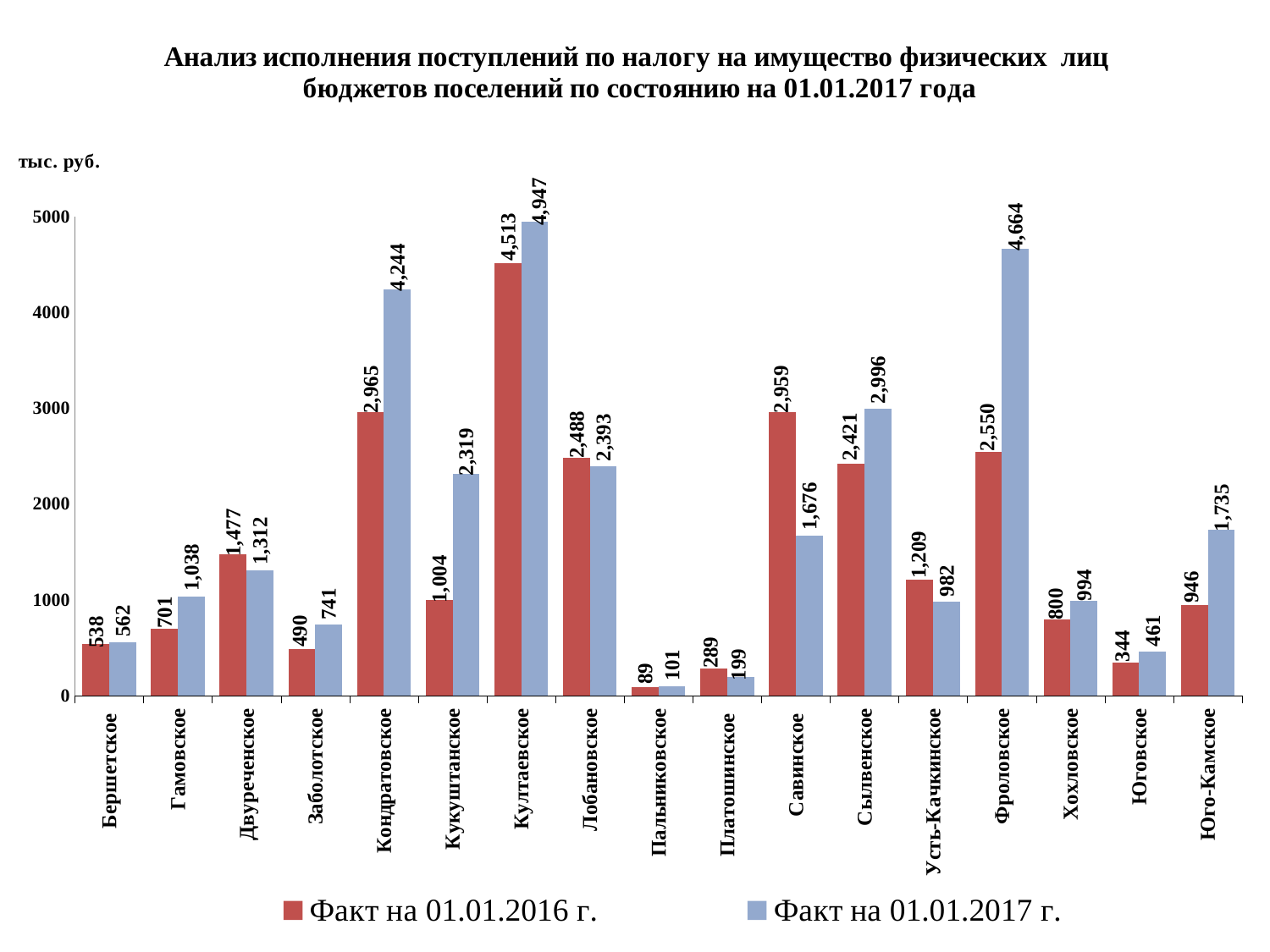
What is the value for Савинское in the series 'Факт на 01.01.2016 г.'? 2,959 What is the value for Фроловское in the series 'Факт на 01.01.2017 г.'? 4,664 How many series does the legend list? 2 Is the value for Кукуштанское in the series 'Факт на 01.01.2017 г.' greater or less than 2000? greater Which category has the lowest value in the series 'Факт на 01.01.2016 г.'? Пальниковское What is the difference between the 2017 and 2016 values for Фроловское? 2,114 Which is larger for Савинское: the value for 'Факт на 01.01.2016 г.' or 'Факт на 01.01.2017 г.'? Факт на 01.01.2016 г. Which category has the highest value in the series 'Факт на 01.01.2017 г.'? Култаевское What is the difference between the 2017 and 2016 values for Кондратовское? 1,279 What kind of chart is shown on the slide? Bar chart How many categories (settlements) are shown on the x axis? 17 What is the value for Юго-Камское in the series 'Факт на 01.01.2017 г.'? 1,735